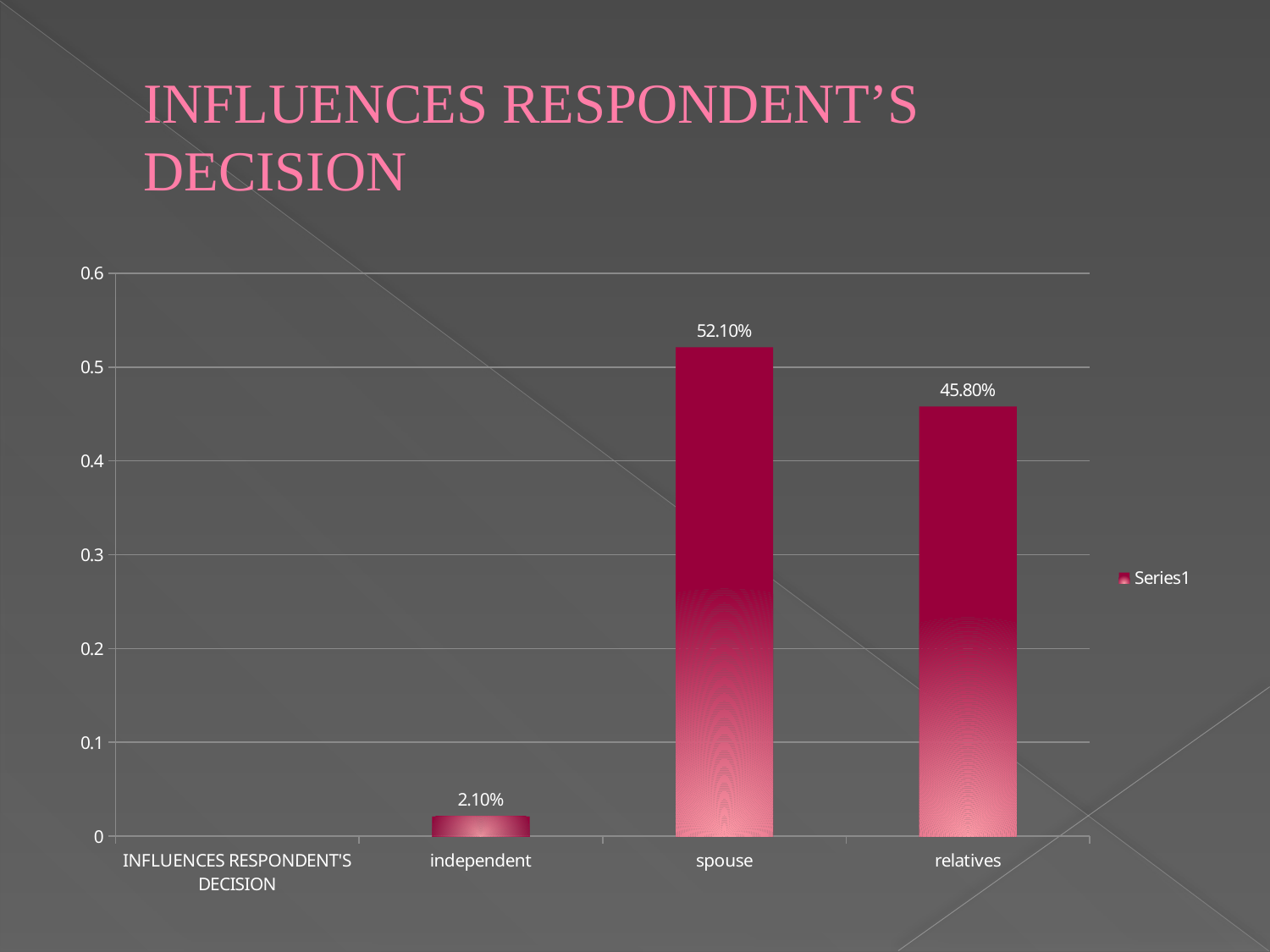
What is the difference between the values for spouse and relatives? 6.30% What is the value for independent? 2.10% What is the value for relatives? 45.80% What is the value for spouse? 52.10% Which category has the lowest plotted value? independent What kind of chart is shown on the slide? bar chart Is the value for relatives greater or less than 0.5? less How many bars are plotted on the chart? 3 Which category has the highest value? spouse What is the difference between the values for relatives and independent? 43.70% How many series does the legend list? 1 Which is larger, the value for spouse or the value for relatives? spouse